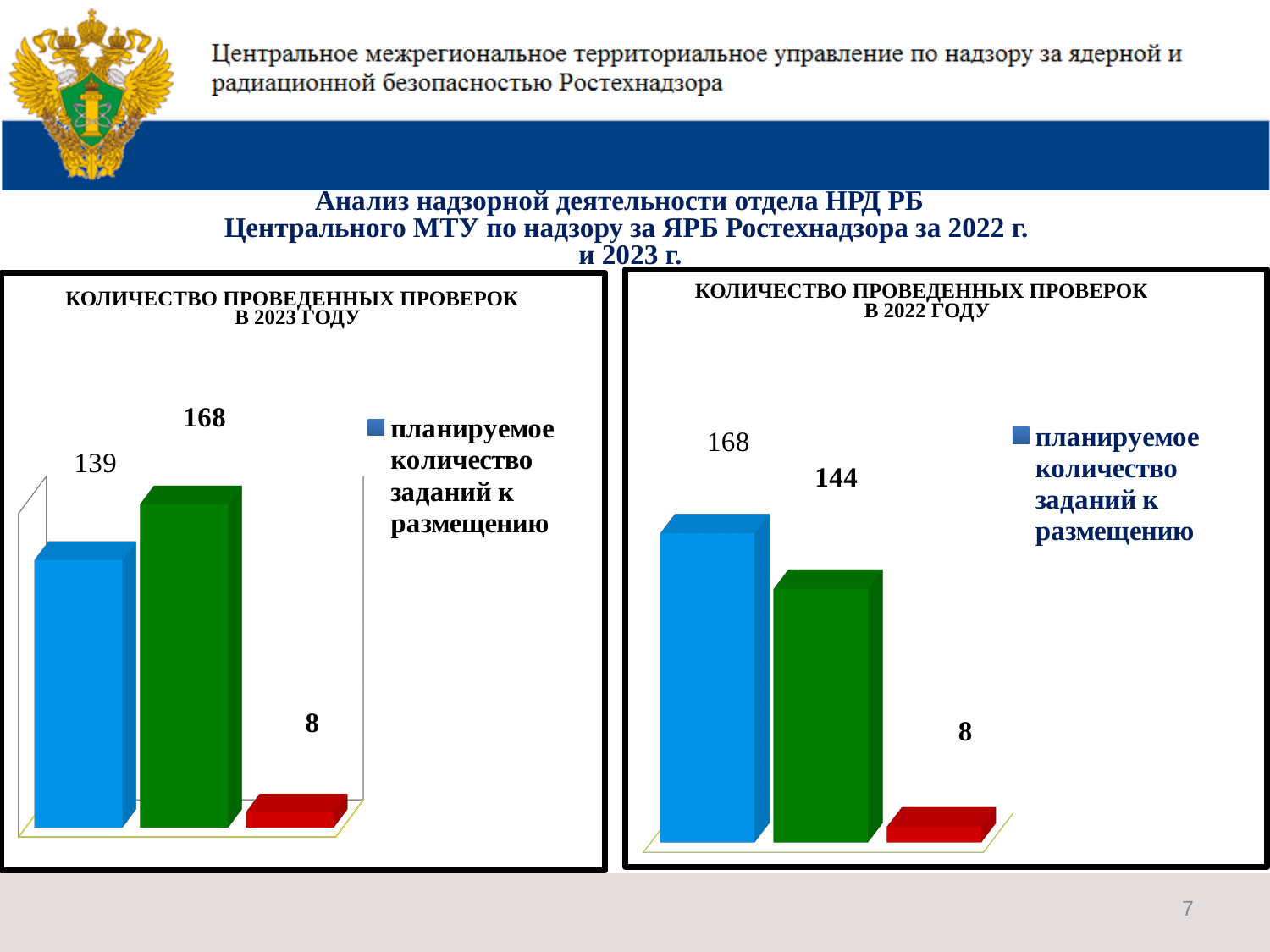
In the left chart (2023), what is the highest value shown? 168 In the chart titled 'КОЛИЧЕСТВО ПРОВЕДЕННЫХ ПРОВЕРОК В 2023 ГОДУ', what is the value for 'планируемое количество заданий к размещению'? 139 In the chart titled 'КОЛИЧЕСТВО ПРОВЕДЕННЫХ ПРОВЕРОК В 2022 ГОДУ', what is the value for 'планируемое количество заданий к размещению'? 168 In the left chart (2023), what is the value shown on the green bar? 168 In the right chart (2022), what is the lowest value shown? 8 In the right chart (2022), what is the difference between the blue bar value and the green bar value? 24 What kind of chart is the left chart (2023)? Bar chart In the left chart (2023), what is the value shown on the red bar? 8 How many bars are plotted in the chart titled 'КОЛИЧЕСТВО ПРОВЕДЕННЫХ ПРОВЕРОК В 2022 ГОДУ'? 3 In the right chart (2022), what is the value shown on the green bar? 144 In the left chart (2023), what is the difference between the green bar value and the blue bar value? 29 Which is larger: the value for 'планируемое количество заданий к размещению' in the 2022 chart or in the 2023 chart? 2022 chart